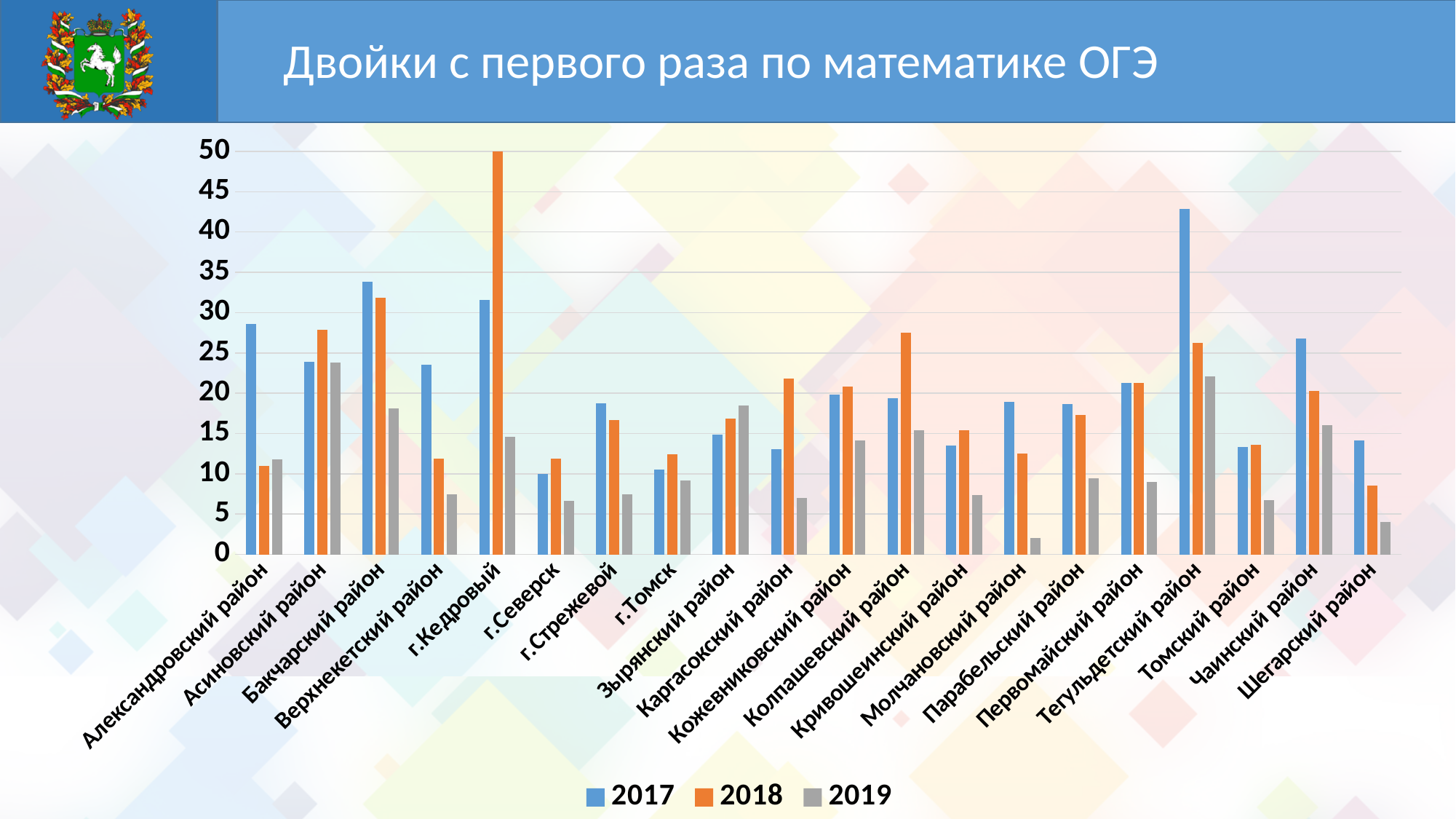
Which district has the lowest value for 2018? Шегарский район Which district has the lowest value for 2019? Молчановский район What kind of chart is shown on the slide? bar chart For Александровский район, which is larger: the 2017 value or the 2018 value? 2017 How many series does the legend list? 3 Which district has the highest value for 2018? г.Кедровый Is the 2018 value for г.Кедровый greater or less than 45? greater Is the 2019 value for Молчановский район greater or less than 5? less For Тегульдетский район, do the values rise or fall from 2017 to 2019? fall Which district has the highest value for 2017? Тегульдетский район Is the 2017 value for Бакчарский район greater or less than 30? greater How many districts (categories) are shown on the x axis? 20